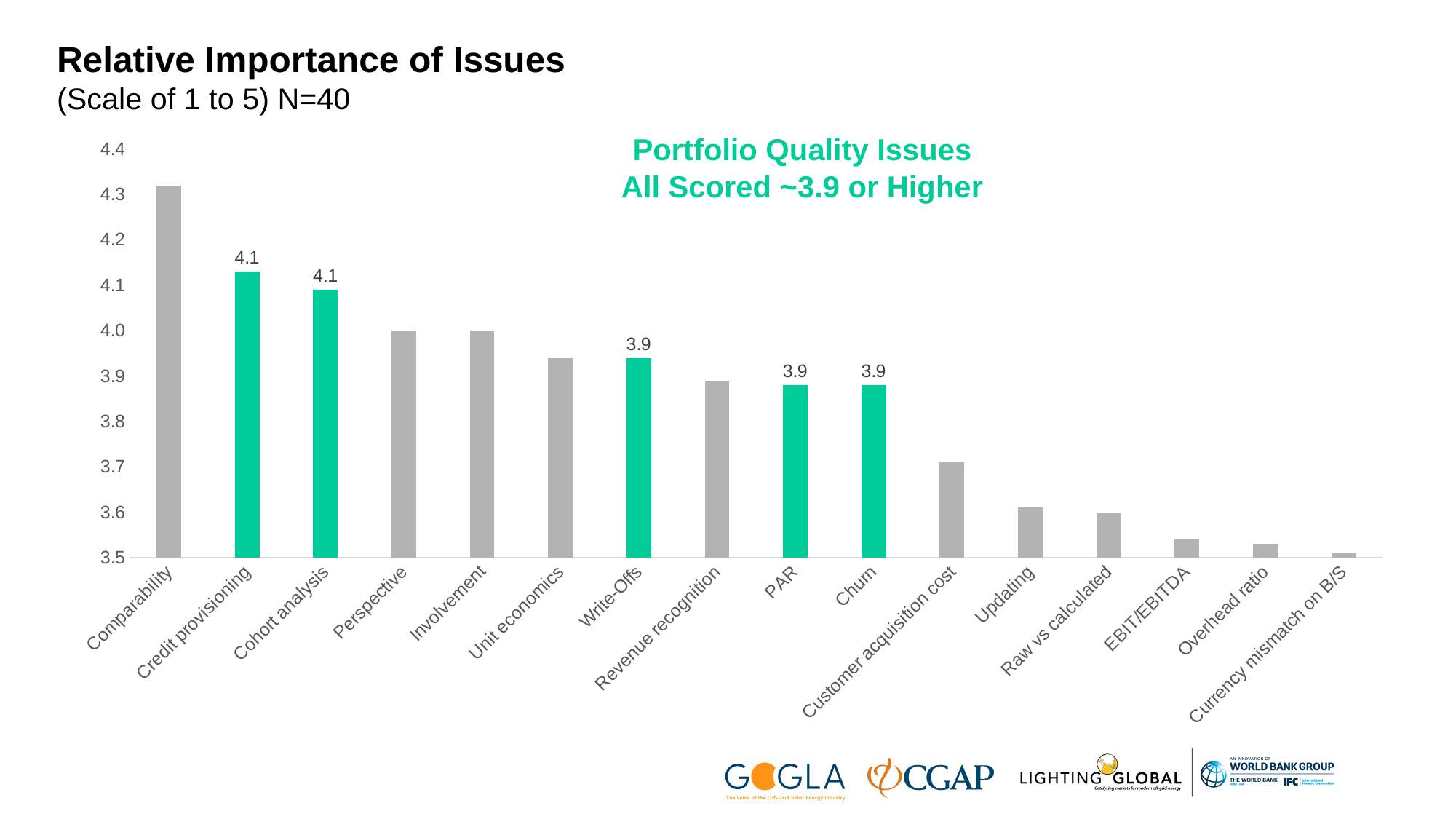
Is the value for Customer acquisition cost greater or less than 3.8? less What is the score for Churn? 3.9 Which has a higher score, Credit provisioning or PAR? Credit provisioning Do the scores generally rise or fall moving from left to right along the x axis? fall How many issues (categories) are plotted on the chart? 16 What kind of chart is shown on the slide? bar chart What is the score for Credit provisioning? 4.1 Is the value for Comparability greater or less than 4.2? greater What is the score for Write-Offs? 3.9 Which issue has the lowest score on the chart? Currency mismatch on B/S Which issue has the highest score on the chart? Comparability What is the difference between the scores for Cohort analysis and Write-Offs? 0.2